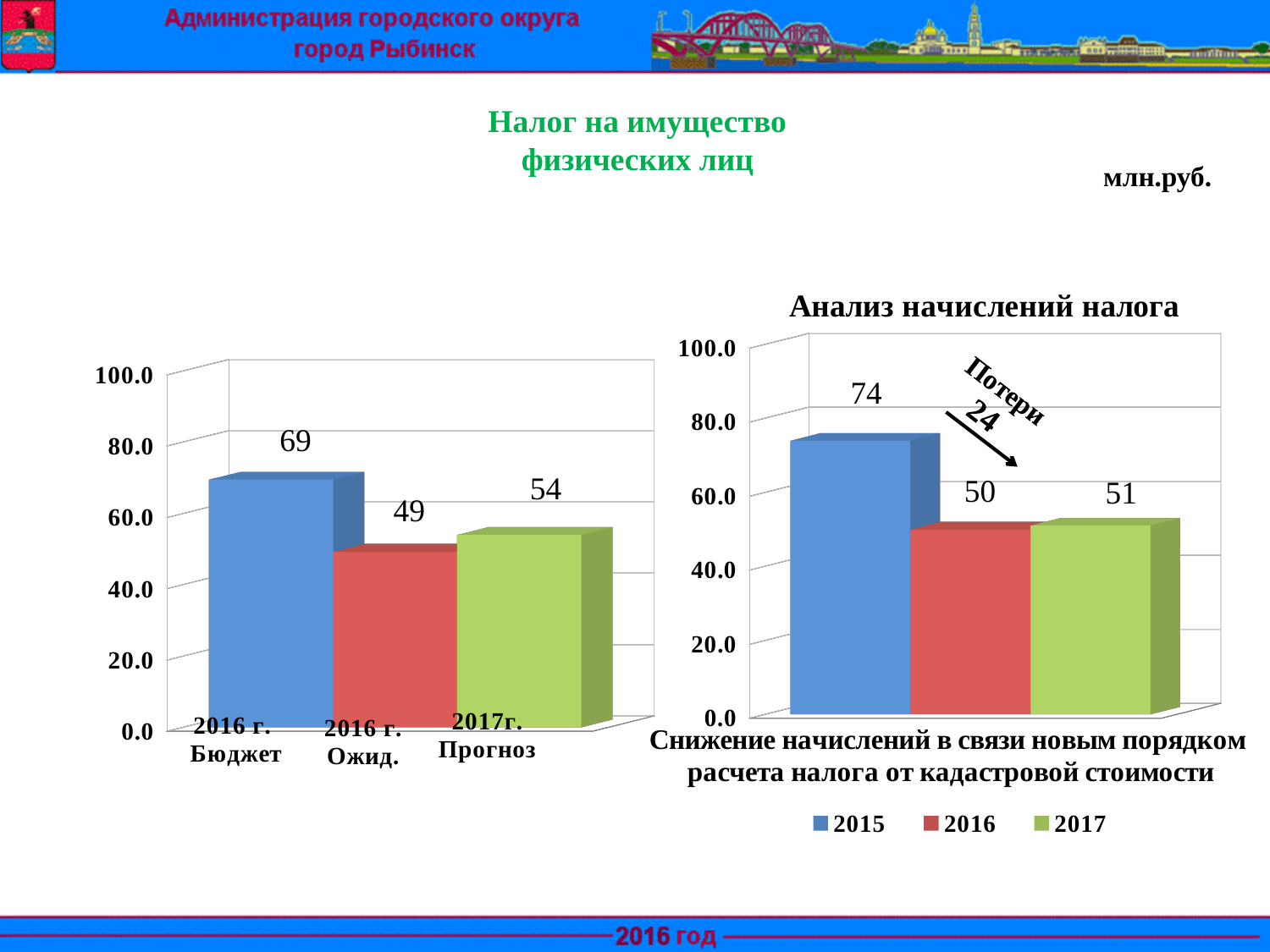
In the chart titled 'Анализ начислений налога', what is the value for 2016? 50 In the left chart, what is the difference between the values for 2016 г. Бюджет and 2016 г. Ожид.? 20 How many series does the legend of the chart titled 'Анализ начислений налога' list? 3 What kind of chart is the left chart? bar chart In the chart titled 'Анализ начислений налога', what is the value for 2015? 74 In the left chart, what is the value for 2017г. Прогноз? 54 In the left chart, which category has the highest value? 2016 г. Бюджет In the left chart, which category has the lowest value? 2016 г. Ожид. In the chart titled 'Анализ начислений налога', what is the difference between the values for 2015 and 2016? 24 In the left chart, what is the value for 2016 г. Ожид.? 49 In the chart titled 'Анализ начислений налога', which year has the highest value? 2015 In the left chart, what is the value for 2016 г. Бюджет? 69